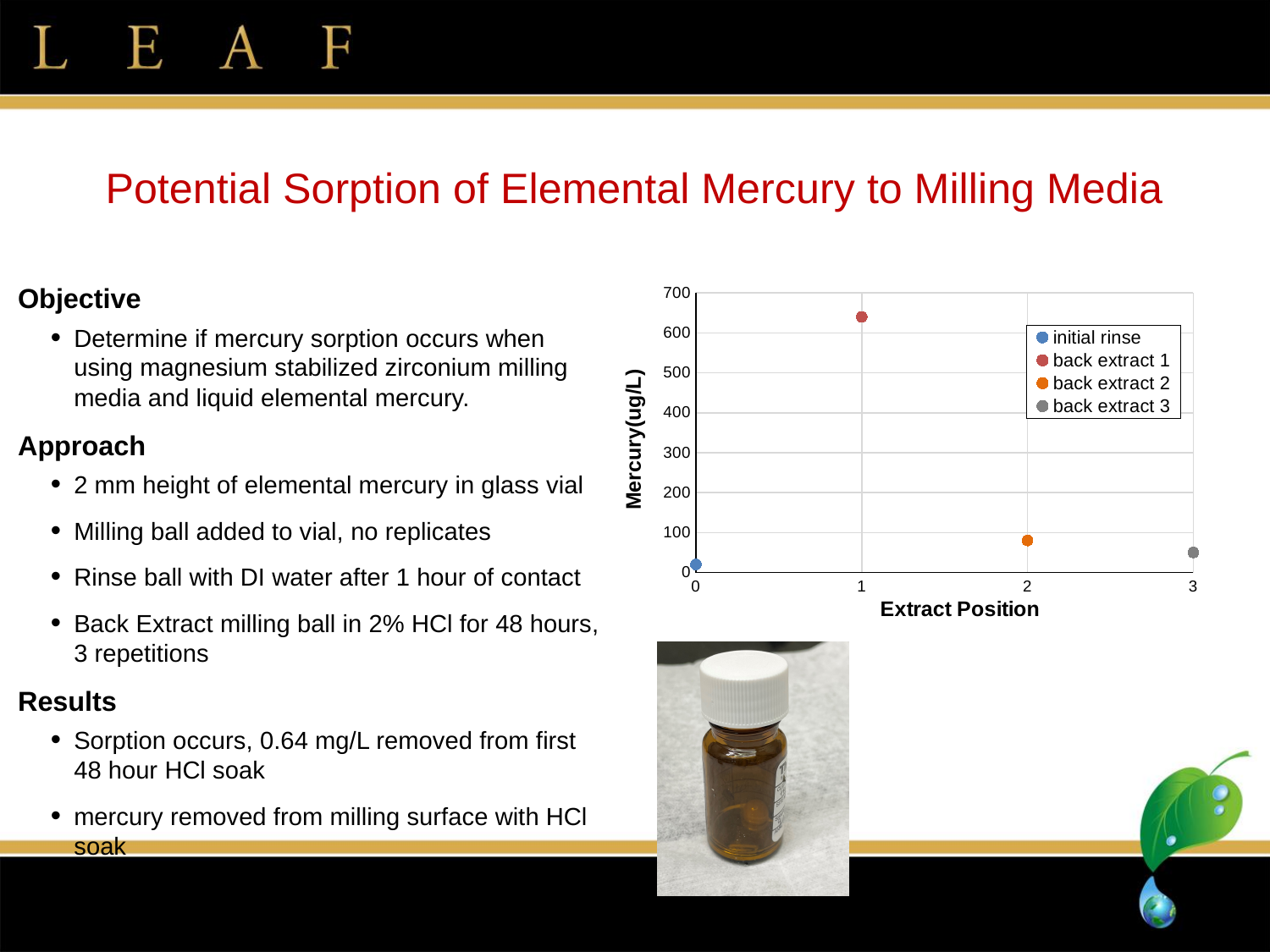
Is the value for back extract 2 greater or less than 100? less What kind of chart is shown on the slide? scatter chart Which series has the highest mercury value on the chart? back extract 1 Is the value for initial rinse greater or less than 100? less Which is larger, the value for back extract 2 or back extract 3? back extract 2 Is the value for back extract 3 greater or less than 100? less What is the label of the chart's y axis? Mercury(ug/L) Do the mercury values rise or fall from extract position 1 to extract position 3? fall How many data points are plotted on the chart? 4 Which is larger, the value for back extract 1 or back extract 2? back extract 1 How many series does the chart's legend list? 4